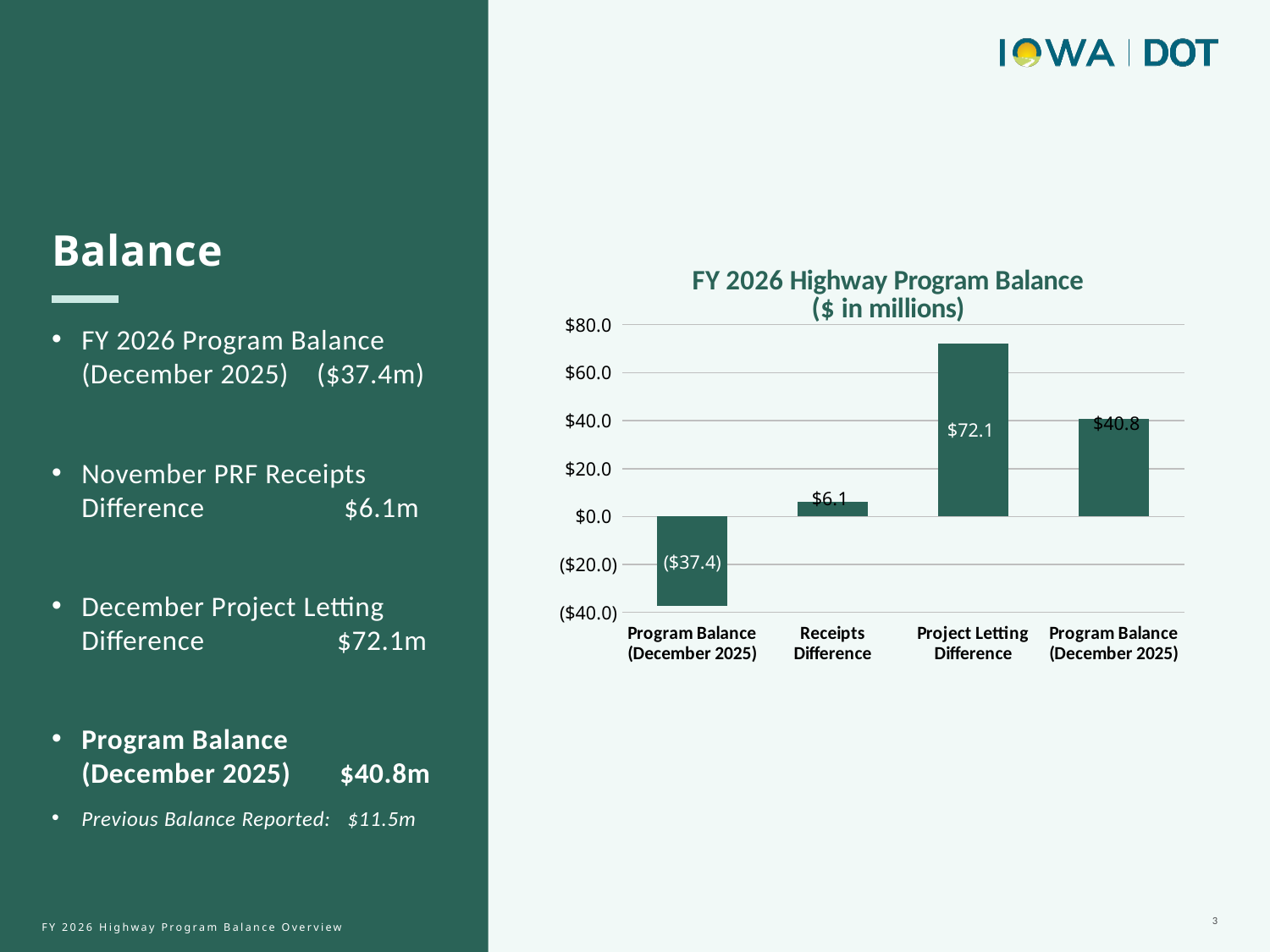
Is the value of the Project Letting Difference bar greater or less than $60.0? greater What type of chart is shown on the slide? bar chart What is the value of the leftmost bar, Program Balance (December 2025)? ($37.4) What is the value of the Project Letting Difference bar? $72.1 Which category has the lowest value in the chart? Program Balance (December 2025), the leftmost bar What is the difference between the Project Letting Difference ($72.1) and the Receipts Difference ($6.1)? $66.0 What is the value of the Receipts Difference bar? $6.1 Which category has the highest value in the chart? Project Letting Difference What is the title of the chart? FY 2026 Highway Program Balance ($ in millions) How many bars are plotted in the chart? 4 Which is larger, the Receipts Difference or the Project Letting Difference? Project Letting Difference What is the value of the rightmost bar, Program Balance (December 2025)? $40.8